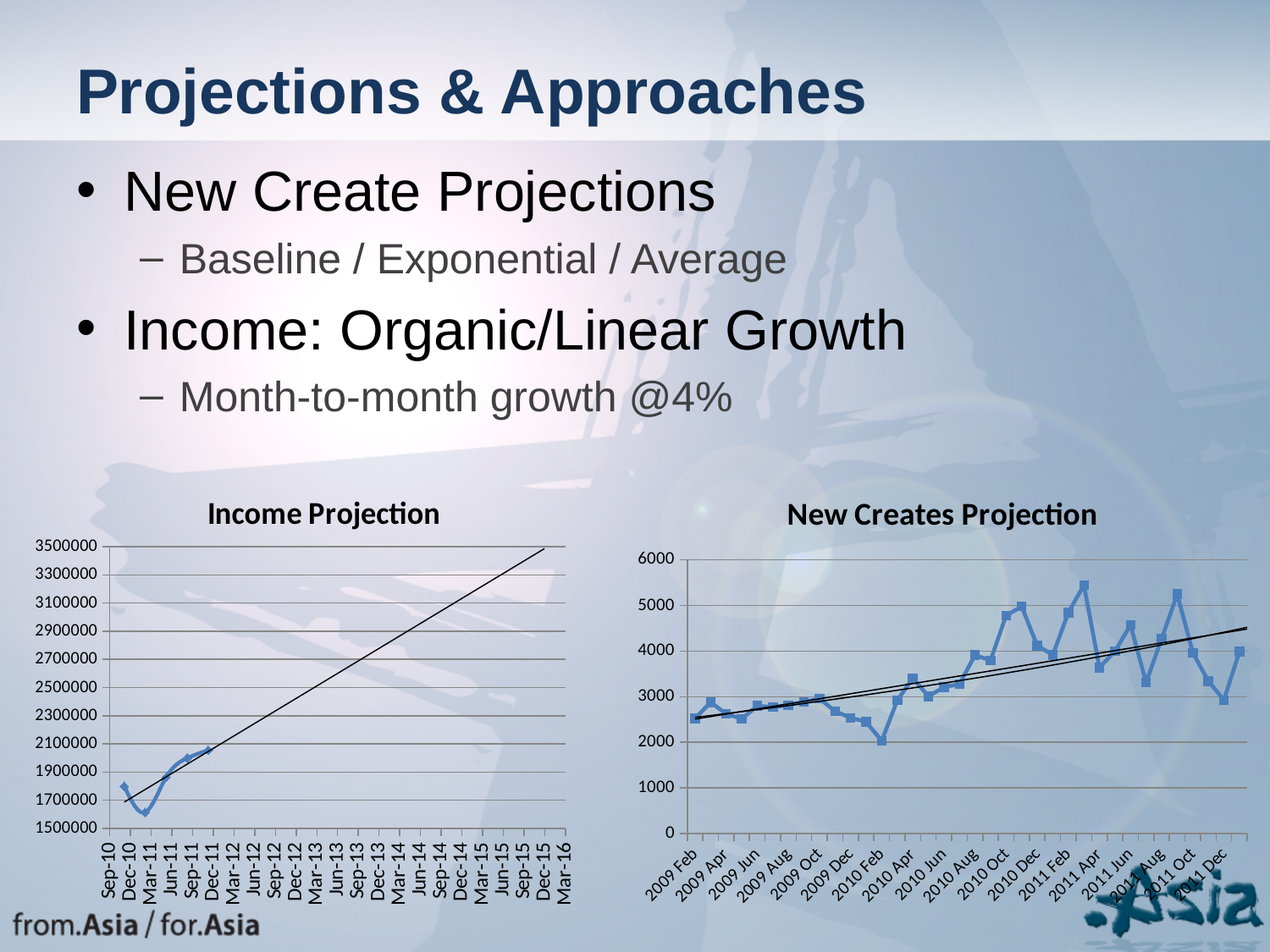
What is the highest value shown on the y axis of the New Creates Projection chart? 6000 What type of chart is the New Creates Projection chart? line chart In the Income Projection chart, is the value for Dec-11 greater or less than 1900000? greater What is the title of the chart on the left of the slide? Income Projection What type of chart is the Income Projection chart? line chart In the New Creates Projection chart, which month has the lowest value? 2010 Feb In the New Creates Projection chart, is the value for 2011 Apr greater or less than 5000? less In the Income Projection chart, does the straight projection line rise or fall from Sep-10 to Mar-16? rise In the New Creates Projection chart, is the value for 2010 Feb greater or less than 3000? less In the New Creates Projection chart, is the value for 2011 Apr larger or smaller than the value for 2010 Feb? larger